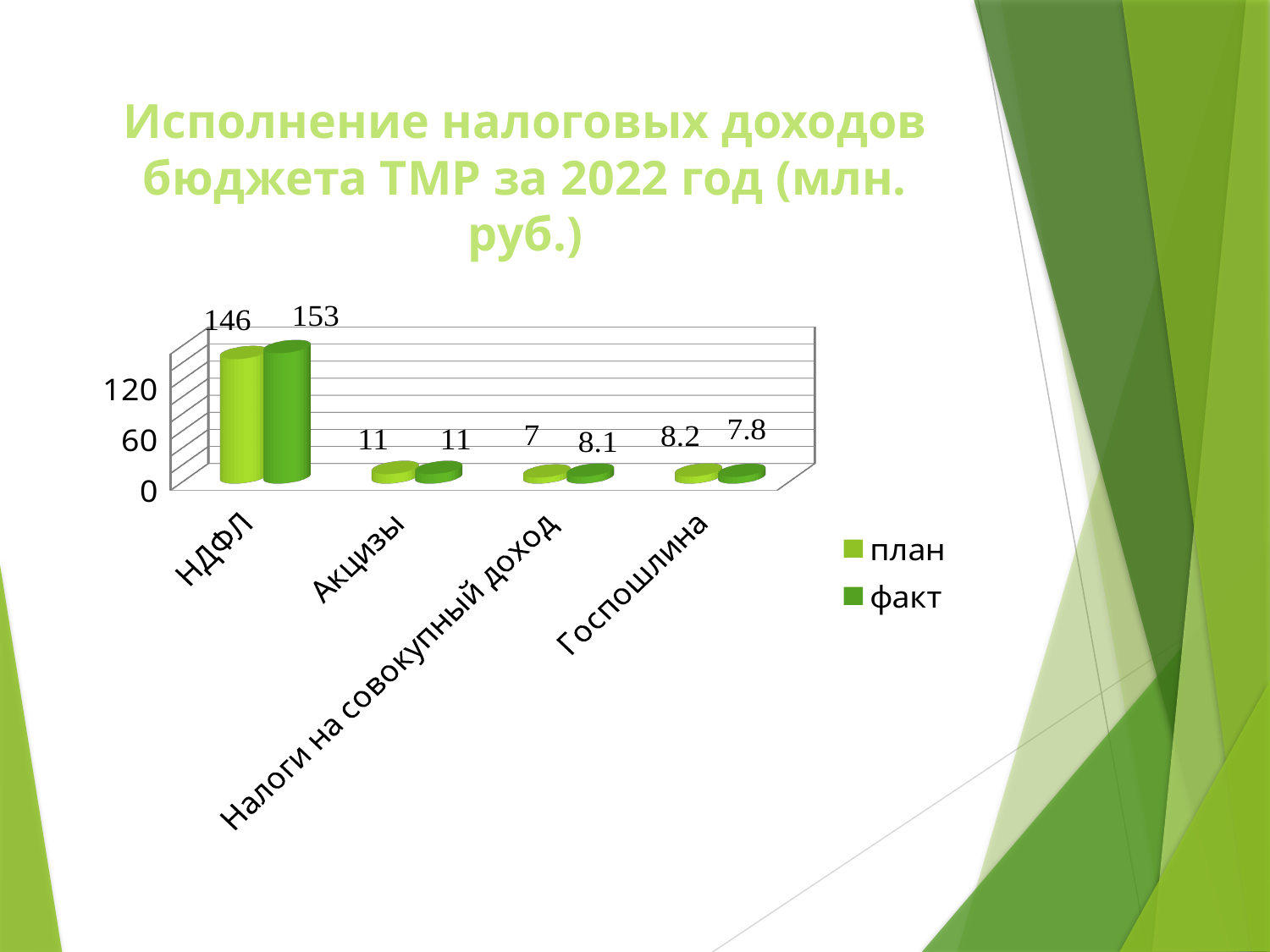
What is the difference between the факт and план values for НДФЛ? 7 For Госпошлина, which is larger: план or факт? план Which category has the highest факт value? НДФЛ How many series does the legend list? 2 What kind of chart is shown on the slide? bar chart Is the факт value for НДФЛ greater or less than 120? greater What is the план value for НДФЛ? 146 What is the факт value for Налоги на совокупный доход? 8.1 Which category has the lowest план value? Налоги на совокупный доход What is the факт value for НДФЛ? 153 How many categories are shown on the x axis? 4 What is the план value for Госпошлина? 8.2